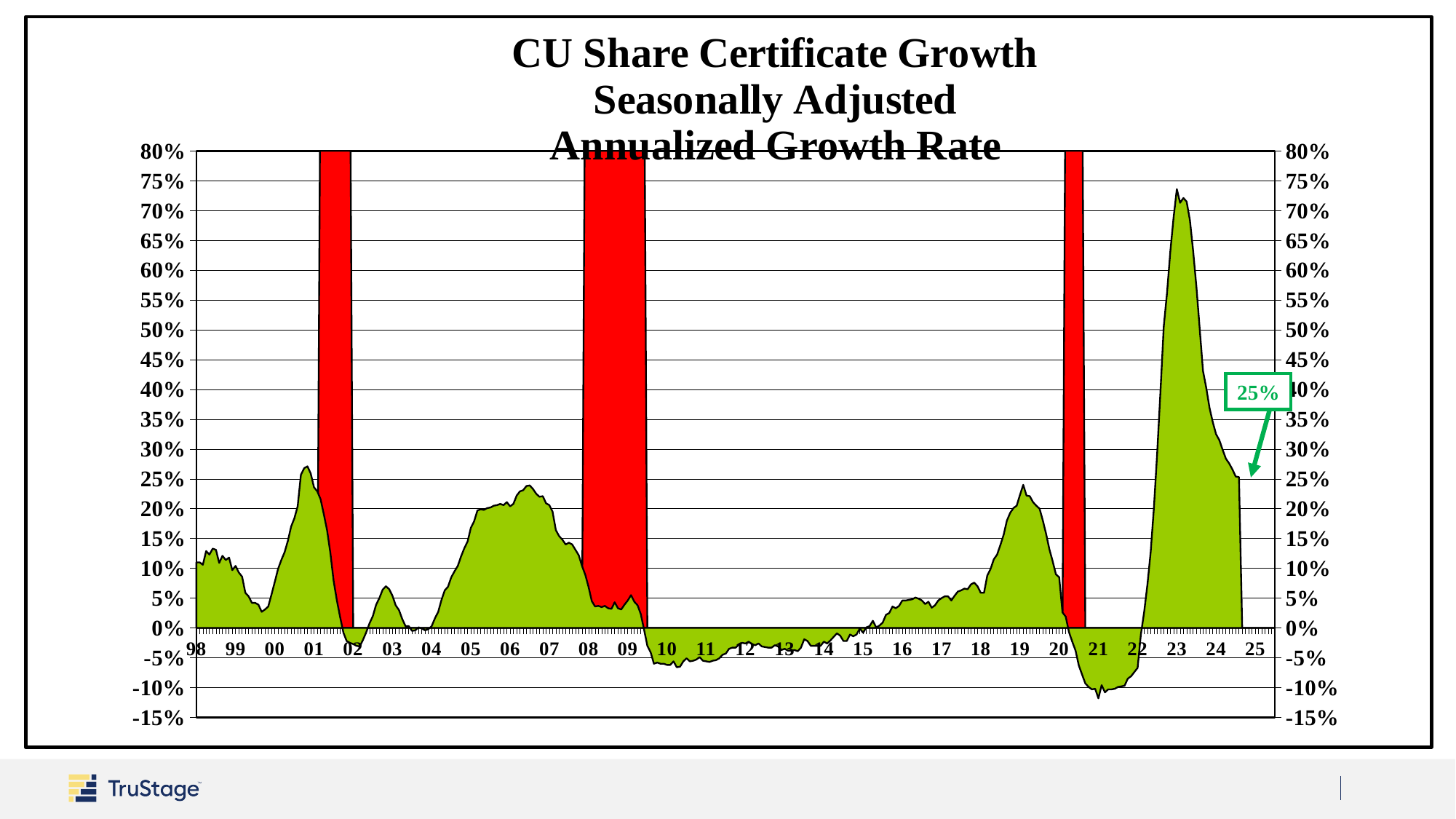
What kind of chart is shown on the slide? area chart Is the growth rate in 2012 greater or less than 0%? less What is the title of the chart? CU Share Certificate Growth Seasonally Adjusted Annualized Growth Rate How many red shaded bands are shown on the chart? 3 What is the highest value shown on the vertical axis? 80% In which year does the growth rate reach its highest point? 23 In which year does the growth rate reach its lowest point? 21 Which peak is higher: the one around 2001 or the one around 2023? 2023 Is the peak growth rate in 2023 greater or less than 70%? greater Does the growth rate rise or fall from 2023 to 2025? fall What is the most recent growth rate value called out on the chart? 25% Is the growth rate in 2021 greater or less than -5%? less